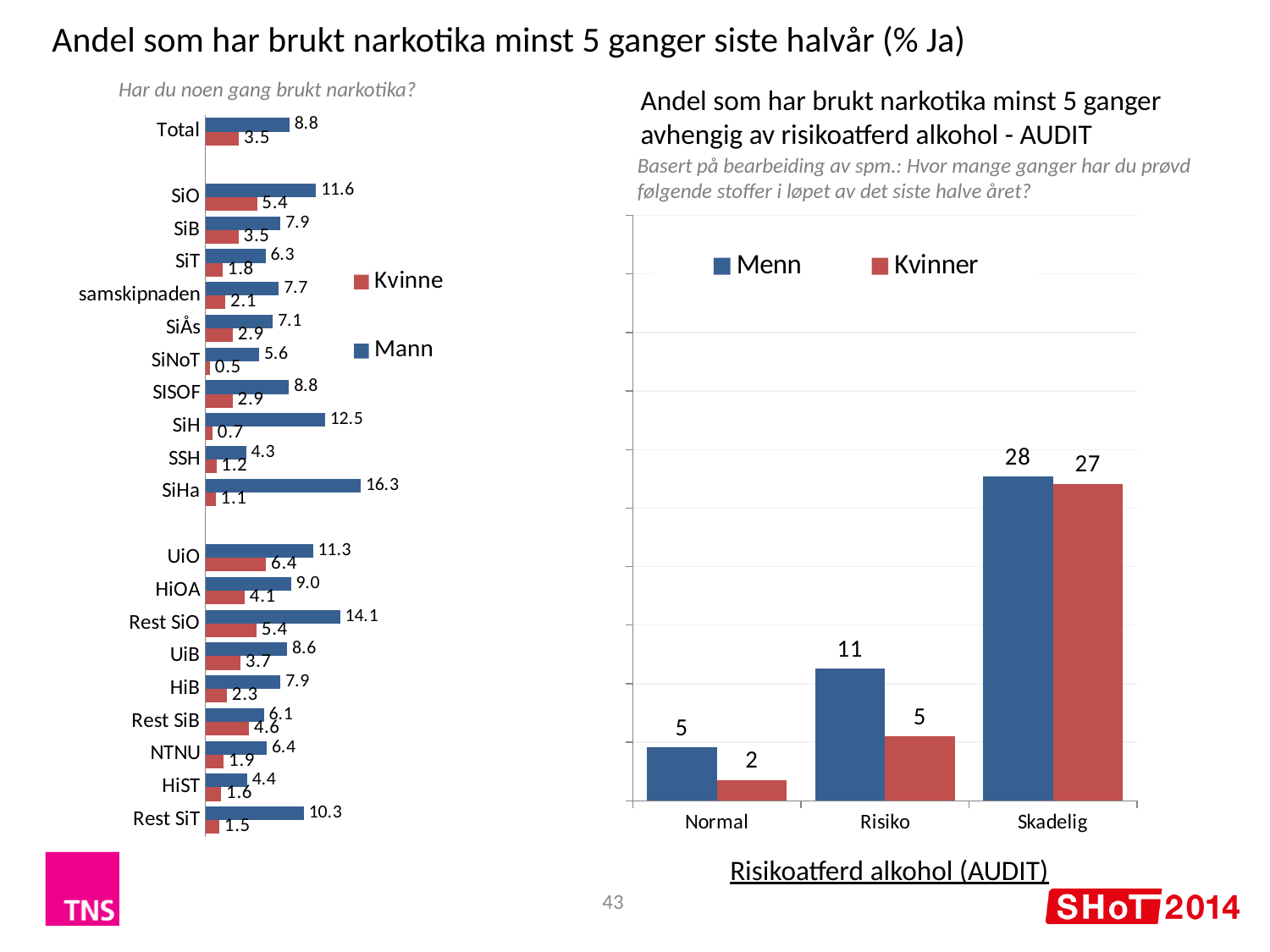
On the left chart, which is larger: the Mann value for SiH or the Mann value for SiO? SiH How many categories are shown on the left chart? 20 On the left chart, which category has the highest Mann value? SiHa On the right chart, what is the difference between Menn and Kvinner for Skadelig? 1 On the right chart, what is the value for Menn for Risiko? 11 On the left chart, what is the value for Mann for SiHa? 16.3 On the left chart, what is the value for Kvinne for UiO? 6.4 On the left chart, what is the difference between the Mann and Kvinne values for Total? 5.3 On the left chart, which category has the lowest Kvinne value? SiNoT On the right chart, what is the value for Kvinner for Normal? 2 On the right chart, do the Menn values rise or fall from Normal to Skadelig? rise How many series does the legend of the right chart list? 2